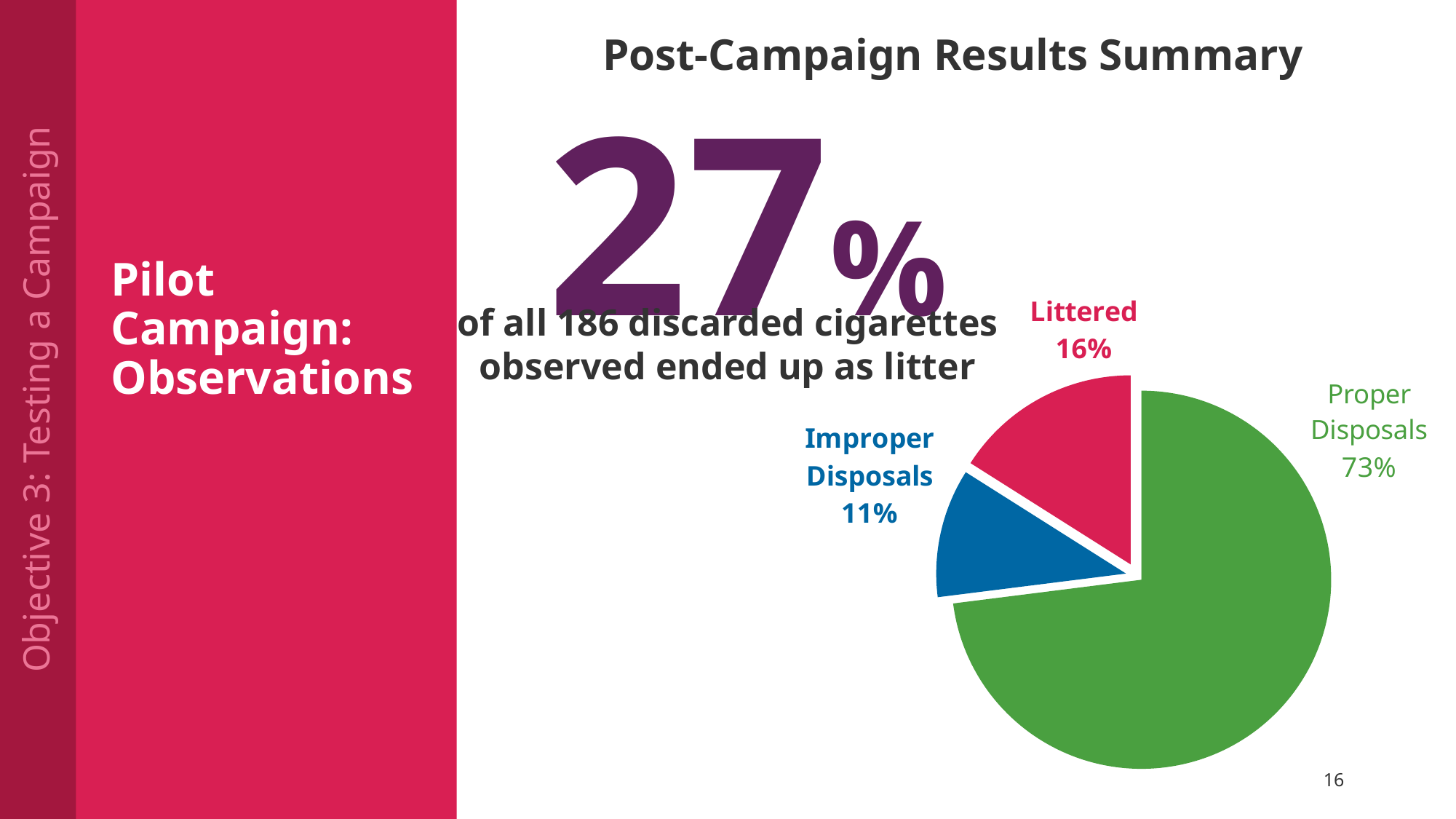
What share of the pie is Littered? 16% Which slice of the pie chart is the smallest? Improper Disposals What share of the pie is Proper Disposals? 73% What colour is the Littered slice? red What share of the pie is Improper Disposals? 11% What is the difference in percentage points between Proper Disposals and Littered? 57 Which is larger, the Littered slice or the Improper Disposals slice? Littered How many slices does the pie chart have? 3 What colour is the Proper Disposals slice? green Which slice of the pie chart is the largest? Proper Disposals What kind of chart is shown on the slide? pie chart What is the difference in percentage points between Littered and Improper Disposals? 5